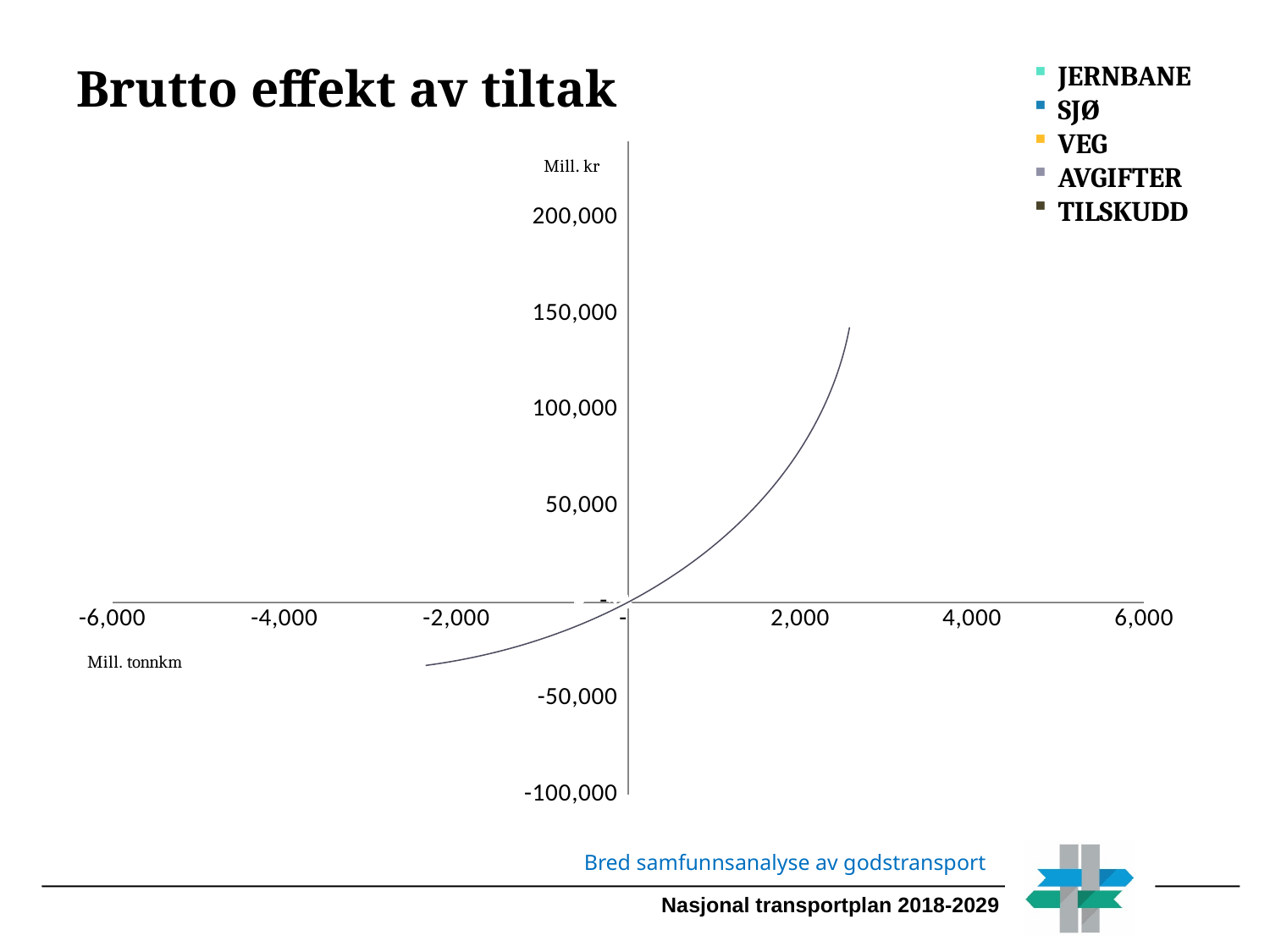
What unit label is shown on the vertical axis? Mill. kr Is the value at the right-hand end of the curve greater or less than 100,000? greater What kind of chart is shown on the slide? line chart What is the title of the chart on the slide? Brutto effekt av tiltak Does the curve rise or fall as you move from left to right along the x axis? rises Is the value at the right-hand end of the curve greater or less than 150,000? less How many entries does the legend list? 5 Is the value at the left-hand end of the curve greater or less than -50,000? greater What is the highest tick value shown on the vertical axis? 200,000